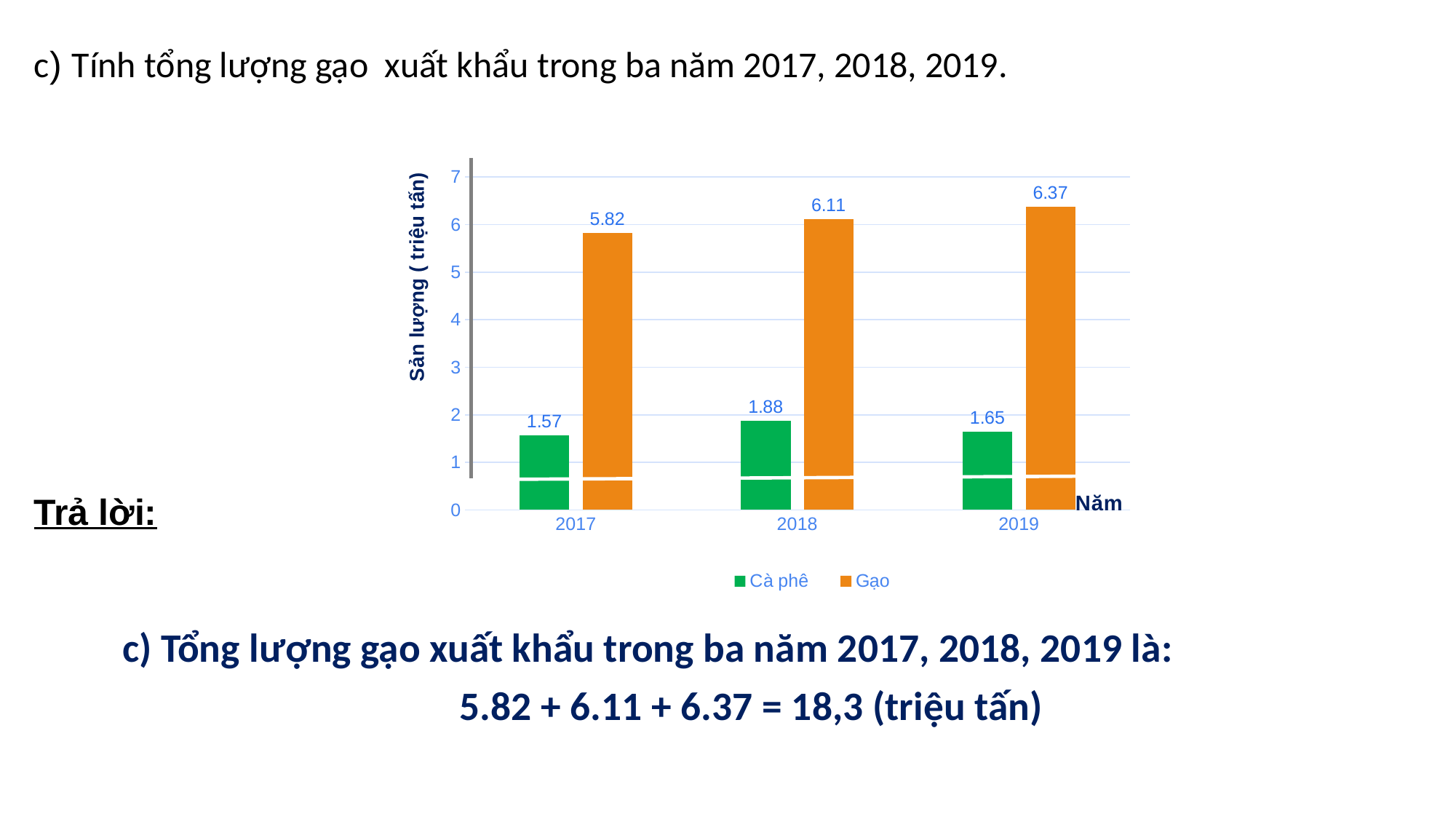
Which is larger, the Cà phê value for 2018 or for 2019? 2018 What is the value for Gạo in 2017? 5.82 What is the value for Cà phê in 2018? 1.88 What is the value for Gạo in 2019? 6.37 In which year is the Cà phê value lowest? 2017 What is the difference between the Gạo values for 2019 and 2017? 0.55 What is the value for Cà phê in 2019? 1.65 How many years are shown on the x axis? 3 In which year is the Gạo value highest? 2019 What kind of chart is shown on the slide? Bar chart How many series does the legend list? 2 Do the Gạo values rise or fall from 2017 to 2019? Rise